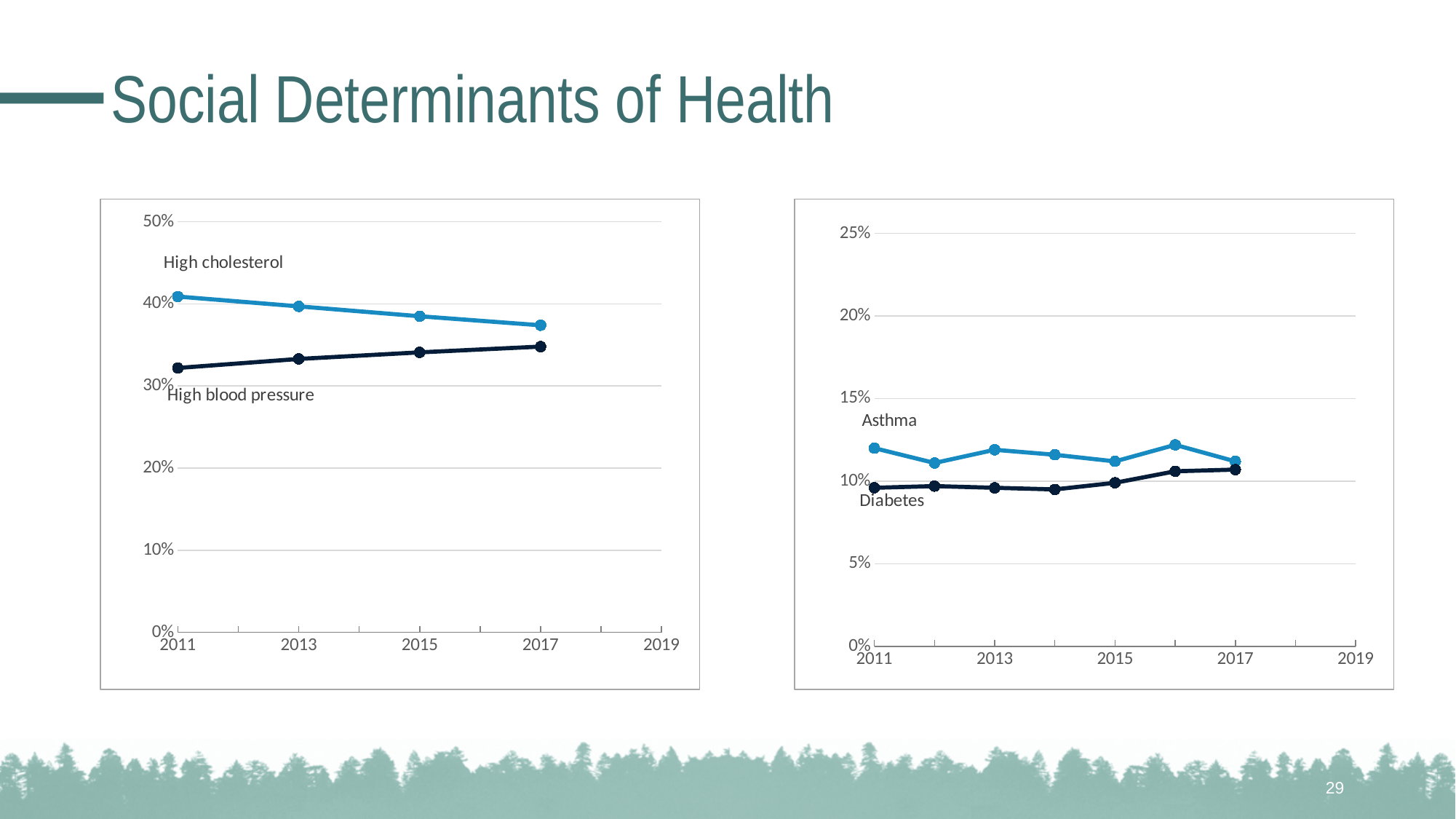
In the right chart, which series is plotted in the lighter blue colour? Asthma In the left chart, how many data points are plotted for the High cholesterol series? 4 In the left chart, is the value for High blood pressure in 2011 greater or less than 30%? greater In the right chart, how many data points are plotted for the Diabetes series? 7 In the left chart, which series has the higher value in 2017, High cholesterol or High blood pressure? High cholesterol What kind of chart is the left chart on the slide? line chart In the left chart, does the High cholesterol line rise or fall from 2011 to 2017? fall What kind of chart is the right chart on the slide? line chart In the left chart, does the High blood pressure line rise or fall from 2011 to 2017? rise In the left chart, is the value for High cholesterol in 2011 greater or less than 40%? greater In the right chart, is the value for Diabetes in 2013 greater or less than 10%? less